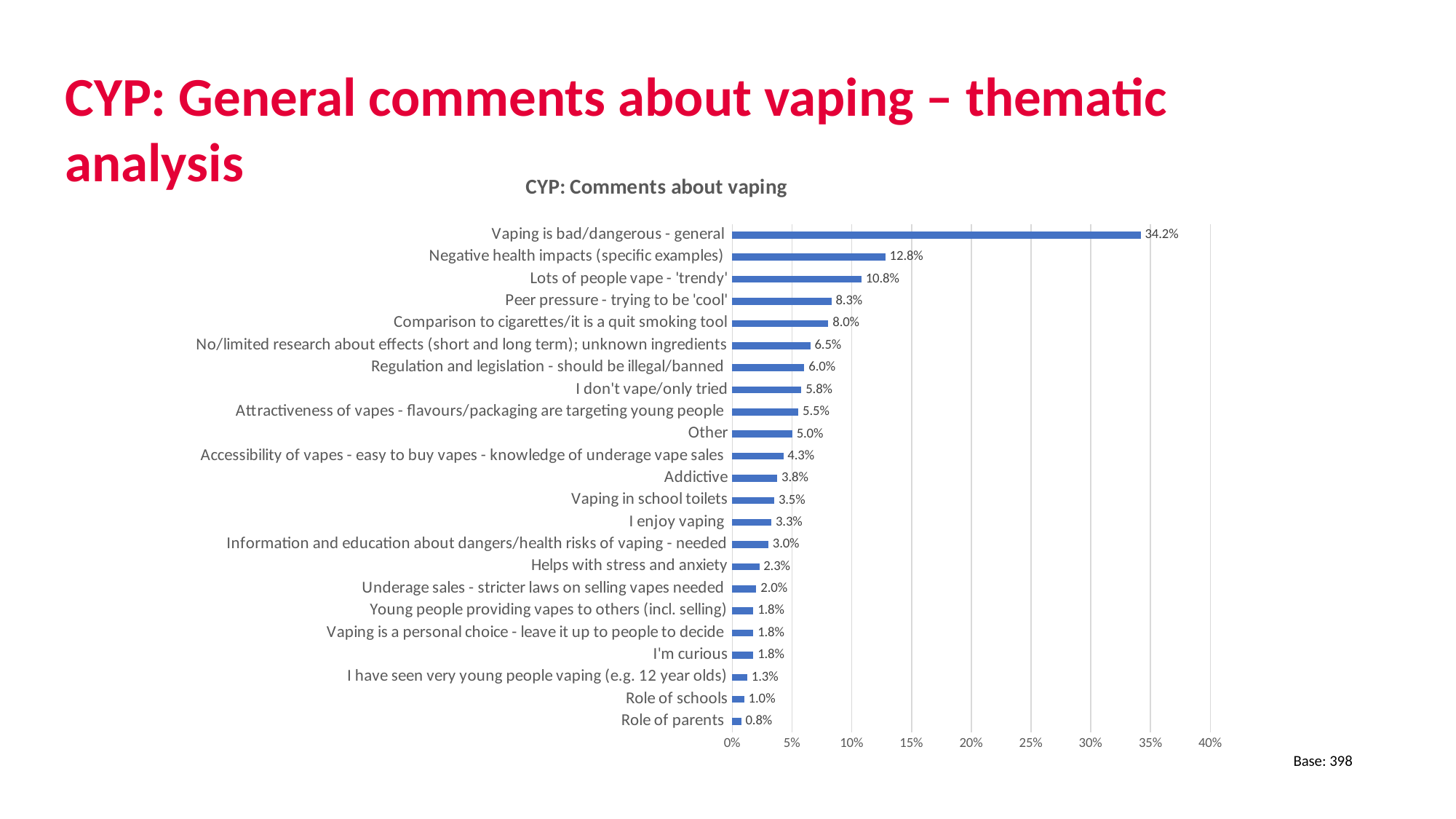
Which category has the highest value? Vaping is bad/dangerous - general What is the value for 'Vaping is bad/dangerous - general'? 34.2% What is the title of the chart? CYP: Comments about vaping What is the value for 'Vaping in school toilets'? 3.5% Which is larger: 'Addictive' or 'I enjoy vaping'? Addictive What is the value for 'Peer pressure - trying to be 'cool''? 8.3% What is the value for 'Role of parents'? 0.8% Which category has the lowest value? Role of parents Is the value for 'Vaping is bad/dangerous - general' greater or less than 30%? greater What kind of chart is this? Bar chart How many categories are shown in the chart? 23 What is the difference between 'Negative health impacts (specific examples)' and 'Lots of people vape - 'trendy''? 2.0%